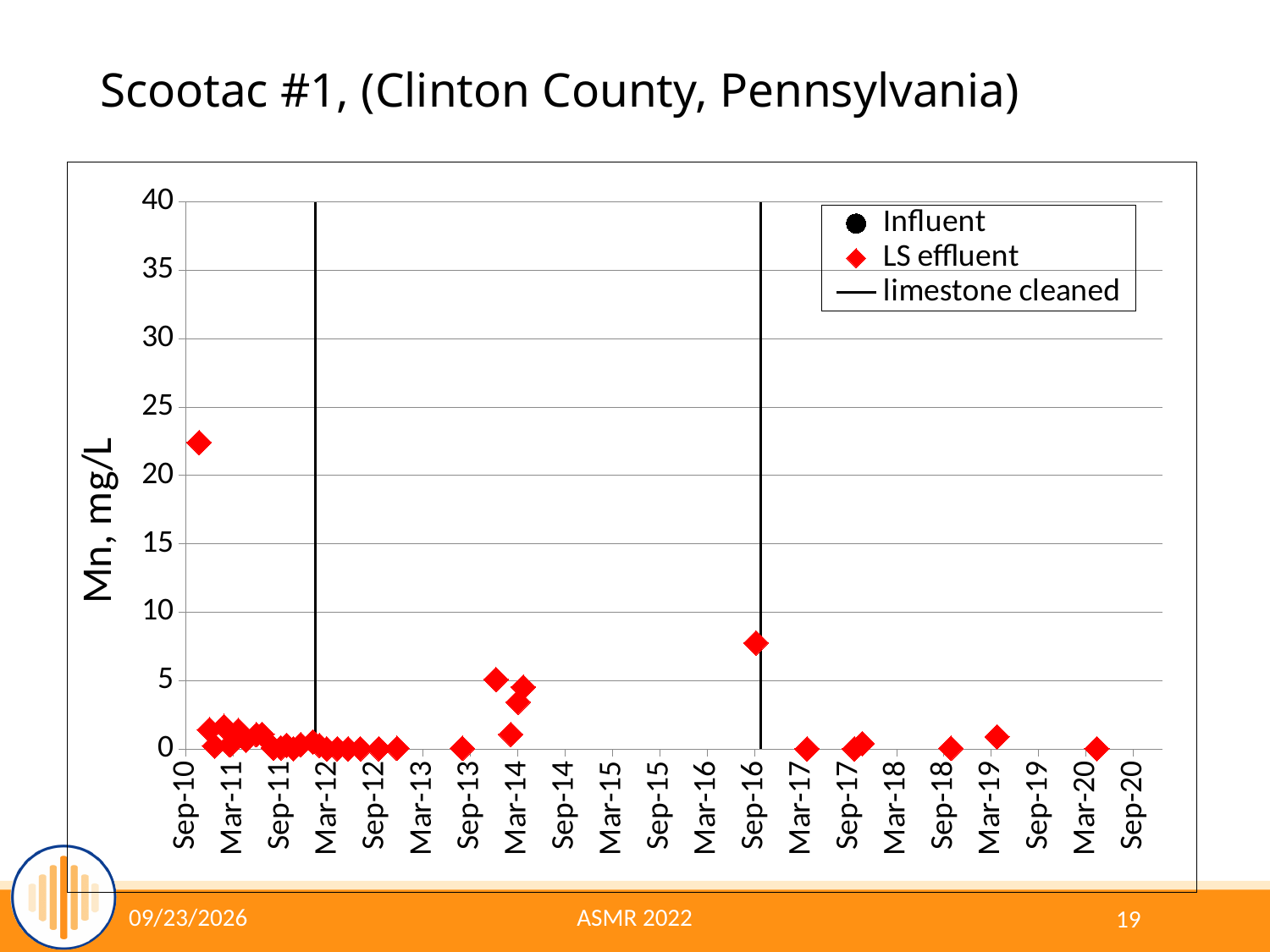
How many series does the legend list? 3 What is the title of the slide containing the chart? Scootac #1, (Clinton County, Pennsylvania) Around which x-axis date does the highest LS effluent value occur? Sep-10 Is the LS effluent value just before the second limestone cleaned line (near Sep-16) greater or less than 5? greater Are the LS effluent values near Mar-14 greater or less than 10? less What kind of chart is shown on the slide? scatter chart Which is larger, the LS effluent value near Sep-10 or the LS effluent value near Sep-16? Sep-10 Is the LS effluent value at the first point near Sep-10 greater or less than 25? less How many vertical limestone cleaned lines are drawn on the chart? 2 What is the label on the y axis? Mn, mg/L